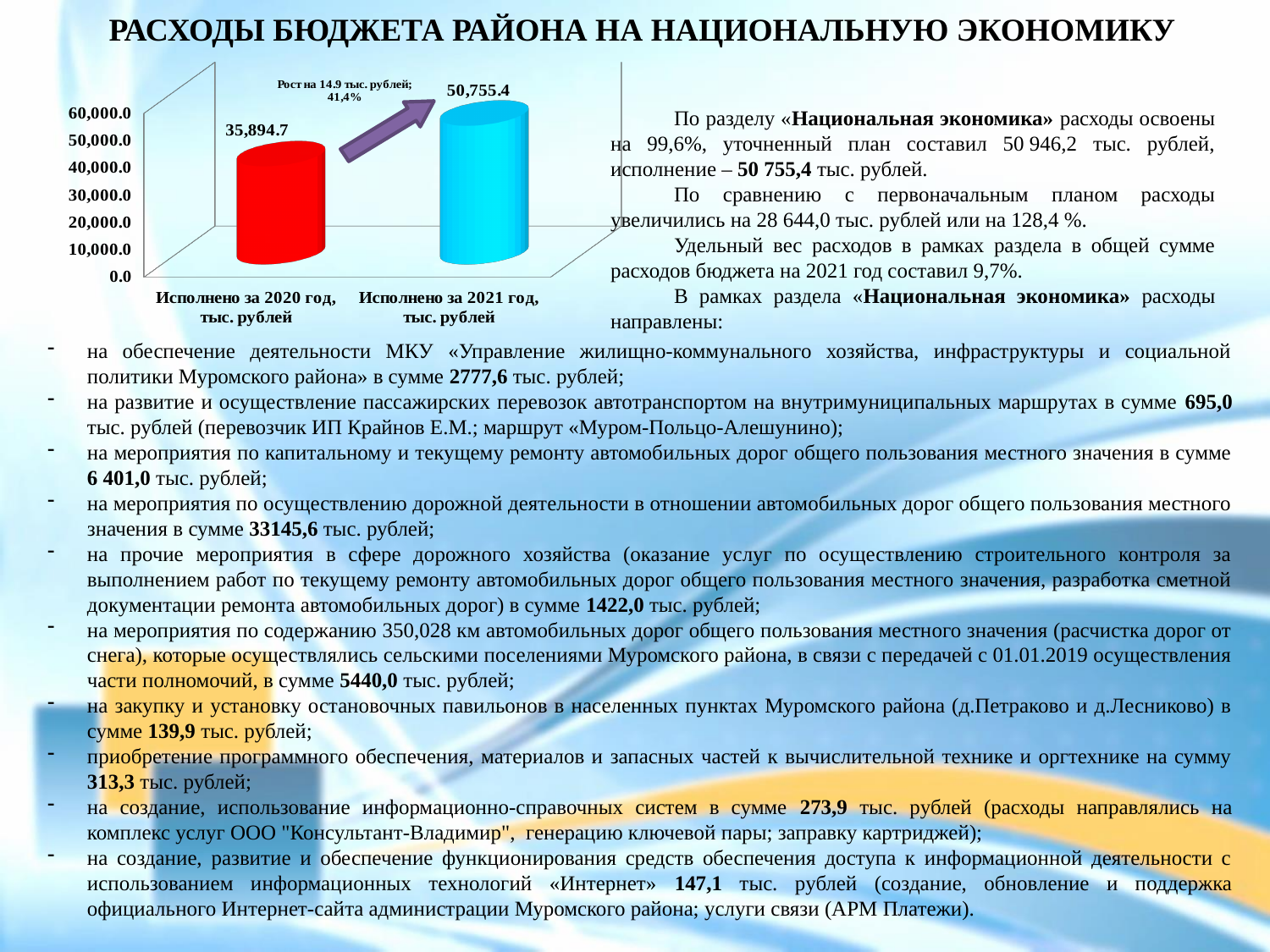
Is the value for "Исполнено за 2021 год, тыс. рублей" greater or less than 40,000.0? greater What is the highest tick value shown on the vertical axis of the chart? 60,000.0 Which category has the highest value? Исполнено за 2021 год, тыс. рублей Which is larger: the value for 2020 or the value for 2021? Исполнено за 2021 год, тыс. рублей What kind of chart is shown on the slide? bar chart How many categories are plotted in the chart? 2 What is the value for "Исполнено за 2020 год, тыс. рублей"? 35,894.7 What is the value for "Исполнено за 2021 год, тыс. рублей"? 50,755.4 Do the values rise or fall from 2020 to 2021? rise What is the difference between the 2021 value and the 2020 value? 14,860.7 Which category has the lowest value? Исполнено за 2020 год, тыс. рублей Is the value for "Исполнено за 2020 год, тыс. рублей" greater or less than 40,000.0? less